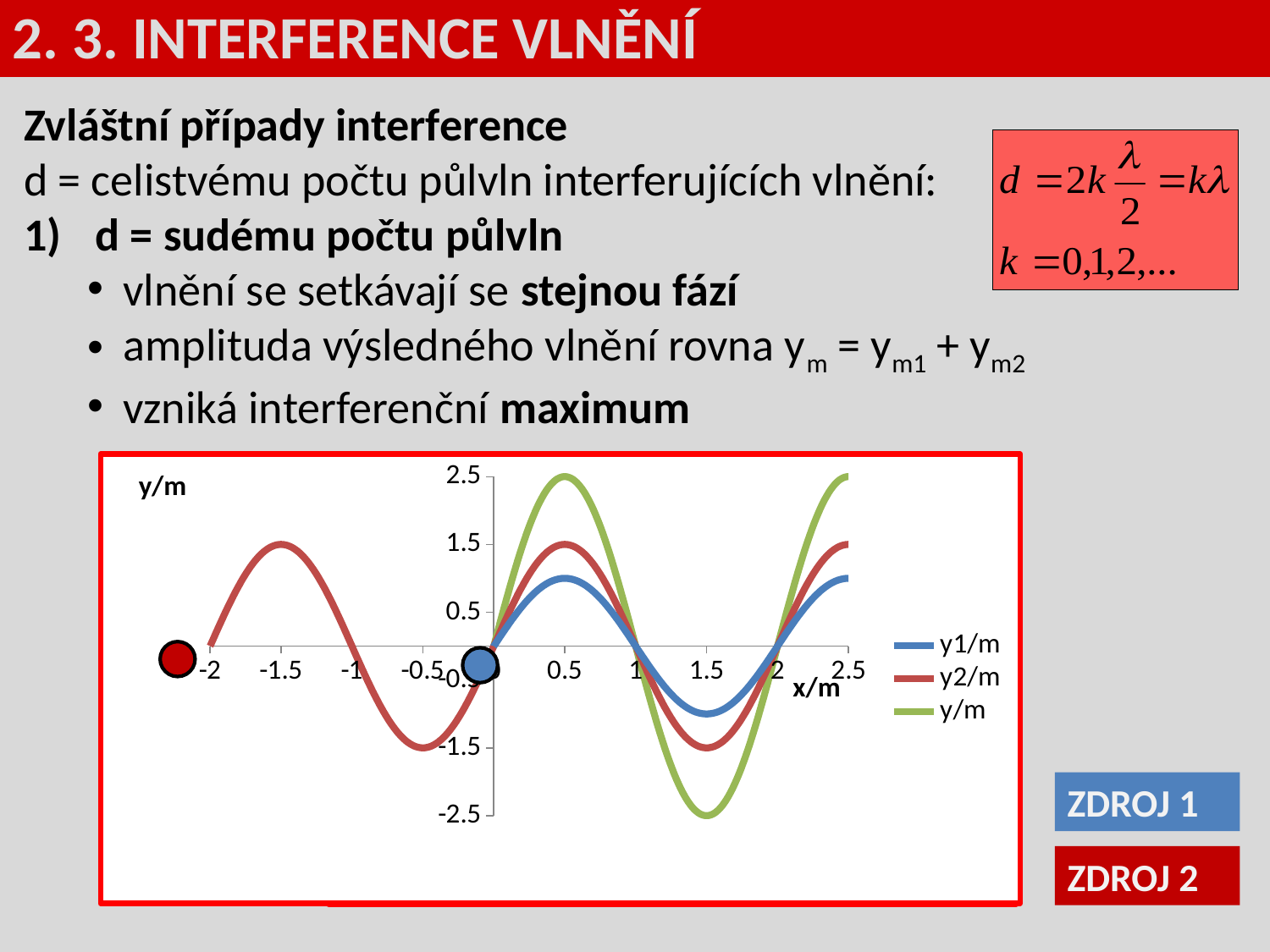
How many series does the chart legend list? 3 What kind of chart is shown on the slide? line chart Is the peak value of the y1/m series at x = 0.5 greater or less than 1.5? less What is the peak value reached by the y2/m series at x = 0.5? 1.5 Is the value of the y/m series at x = 0.5 greater or less than 1.5? greater What is the lowest value reached by the y/m series at x = 1.5? -2.5 What is the label of the horizontal axis of the chart? x/m Which series reaches the highest peak value on the chart? y/m What are the names of the series listed in the chart legend? y1/m, y2/m, y/m What is the peak value reached by the y/m series at x = 0.5? 2.5 Which series has the smallest amplitude on the chart? y1/m At x = 0.5, which series has the larger value, y1/m or y2/m? y2/m